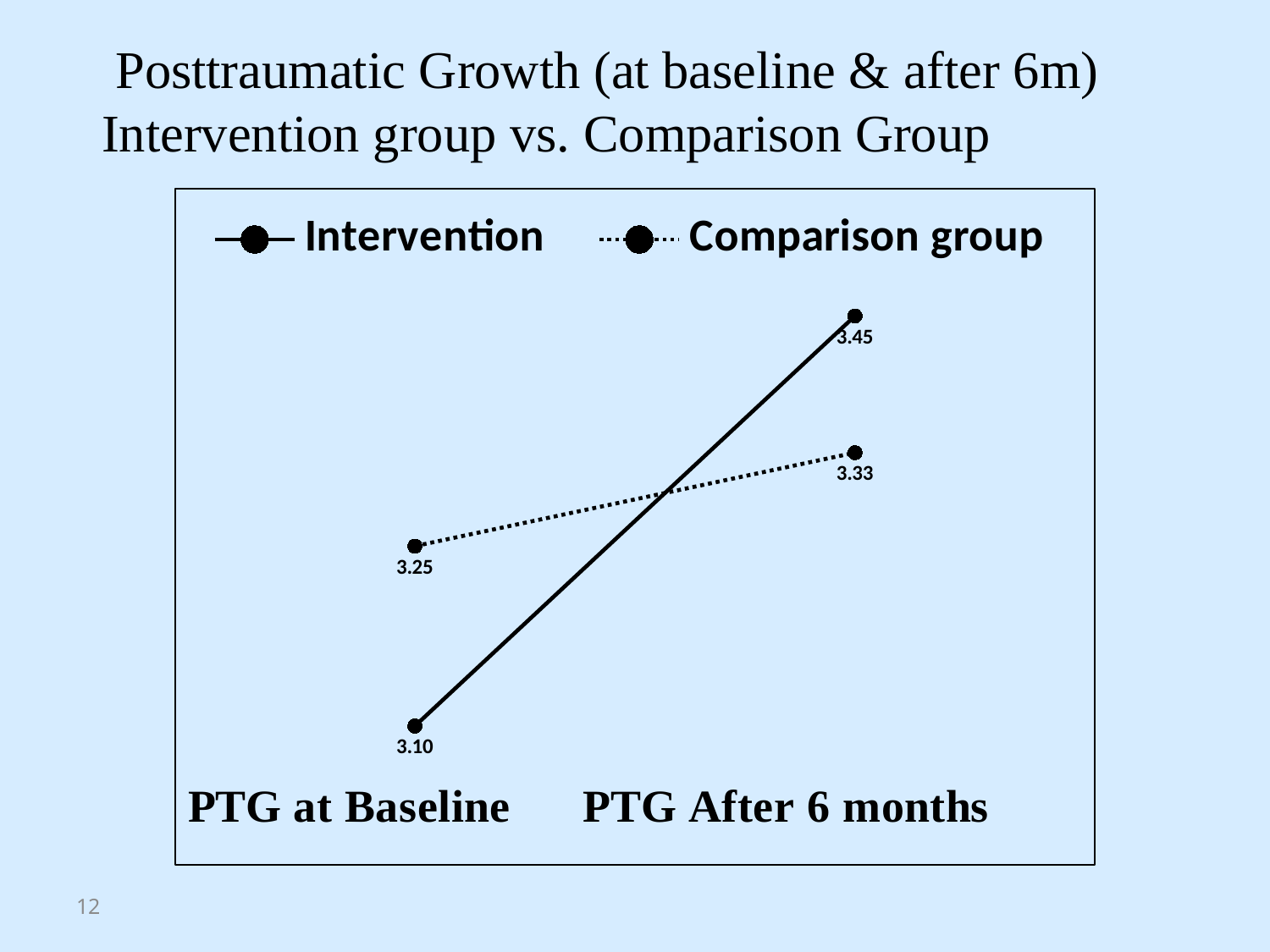
Does the Intervention group's PTG value rise or fall from baseline to 6 months? Rise By how much did the Intervention group's PTG value increase from baseline to 6 months? 0.35 Which group has the higher PTG value after 6 months? Intervention What is the PTG value for the Intervention group at baseline? 3.10 By how much did the Comparison group's PTG value increase from baseline to 6 months? 0.08 Which group has the higher PTG value at baseline? Comparison group What is the difference between the Intervention and Comparison group PTG values after 6 months? 0.12 What is the PTG value for the Comparison group at baseline? 3.25 What is the PTG value for the Comparison group after 6 months? 3.33 What is the PTG value for the Intervention group after 6 months? 3.45 What kind of chart is shown on the slide? Line chart How many series does the legend list? 2